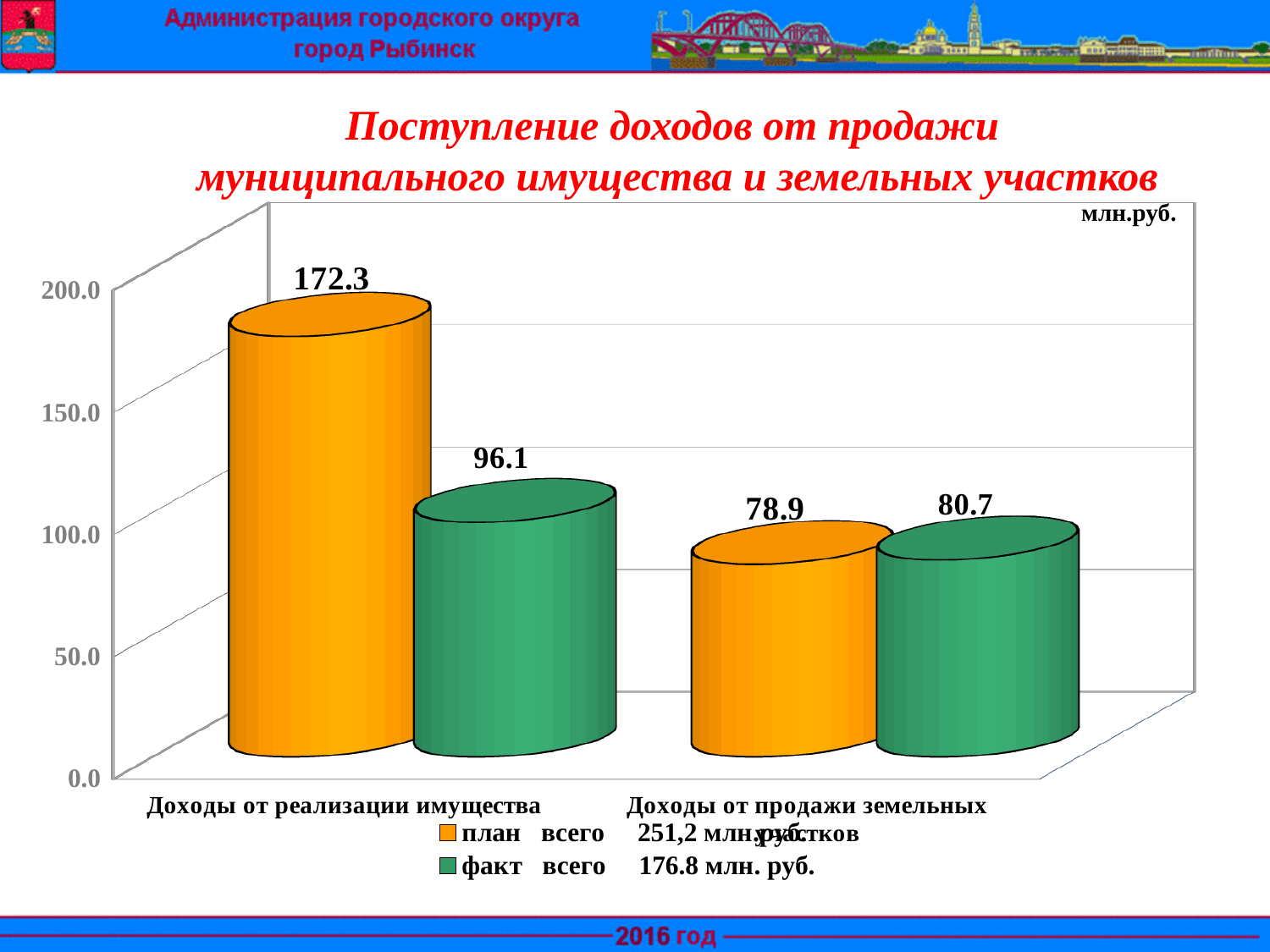
What is the actual (факт) value for Доходы от реализации имущества? 96.1 How many series does the legend list? 2 What unit is indicated in the top right corner of the chart? млн.руб. Is the факт value for Доходы от реализации имущества greater or less than 100.0? less How many categories are shown on the x axis? 2 What is the planned (план) value for Доходы от реализации имущества? 172.3 Which bar has the highest value on the chart? план, Доходы от реализации имущества Which bar has the lowest value on the chart? план, Доходы от продажи земельных участков What is the actual (факт) value for Доходы от продажи земельных участков? 80.7 What is the difference between the план and факт values for Доходы от реализации имущества? 76.2 For Доходы от продажи земельных участков, which is larger: план or факт? факт What is the planned (план) value for Доходы от продажи земельных участков? 78.9